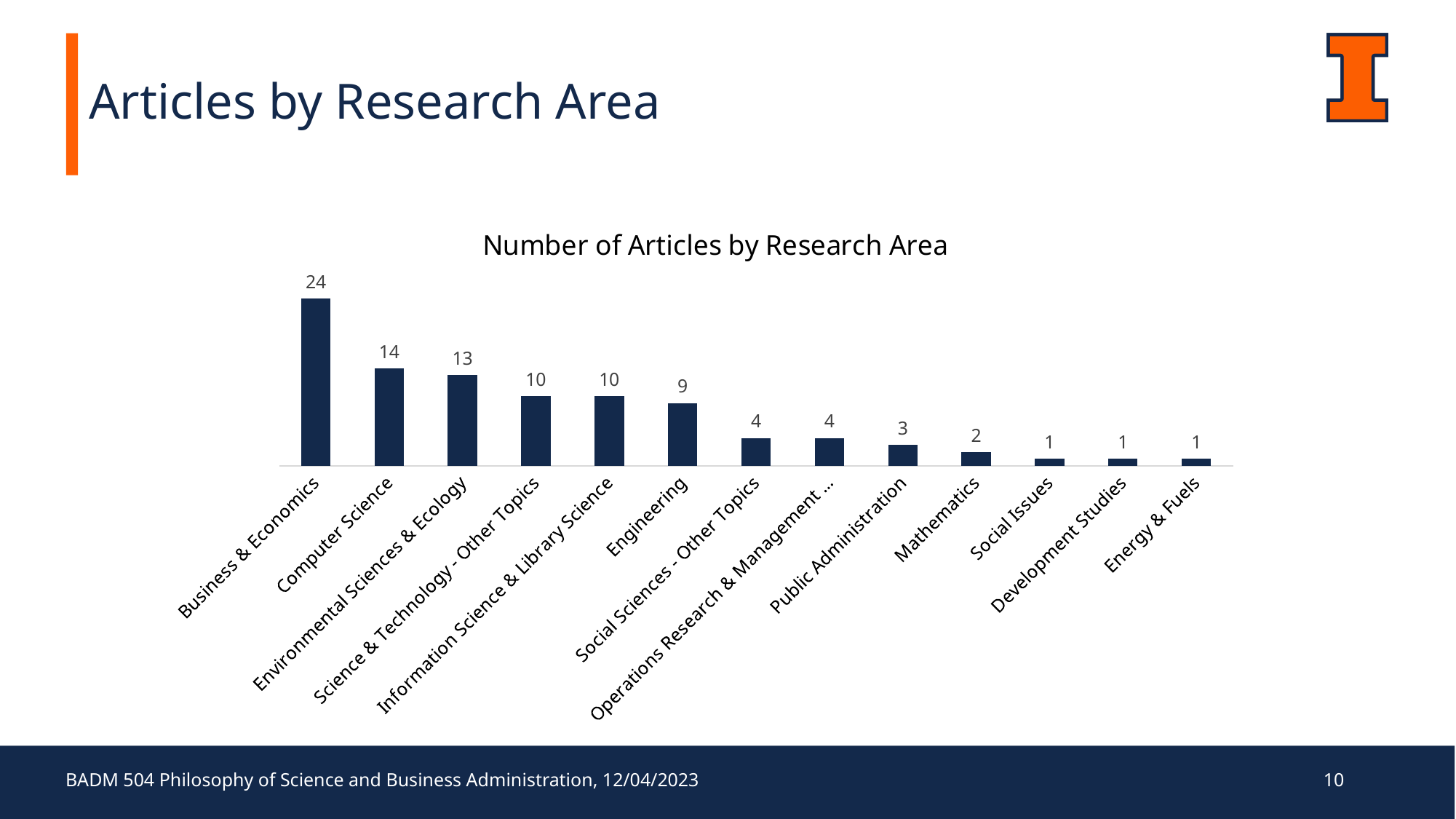
What is the difference in number of articles between Business & Economics and Computer Science? 10 What is the number of articles for Computer Science? 14 What is the title of the chart? Number of Articles by Research Area What is the number of articles for Public Administration? 3 How many research areas are shown in the chart? 13 What is the number of articles for Engineering? 9 What type of chart is shown on the slide? Bar chart What is the difference in number of articles between Environmental Sciences & Ecology and Mathematics? 11 Which research area has the highest number of articles? Business & Economics Which has more articles, Computer Science or Engineering? Computer Science What is the number of articles for Business & Economics? 24 Which has more articles, Public Administration or Mathematics? Public Administration